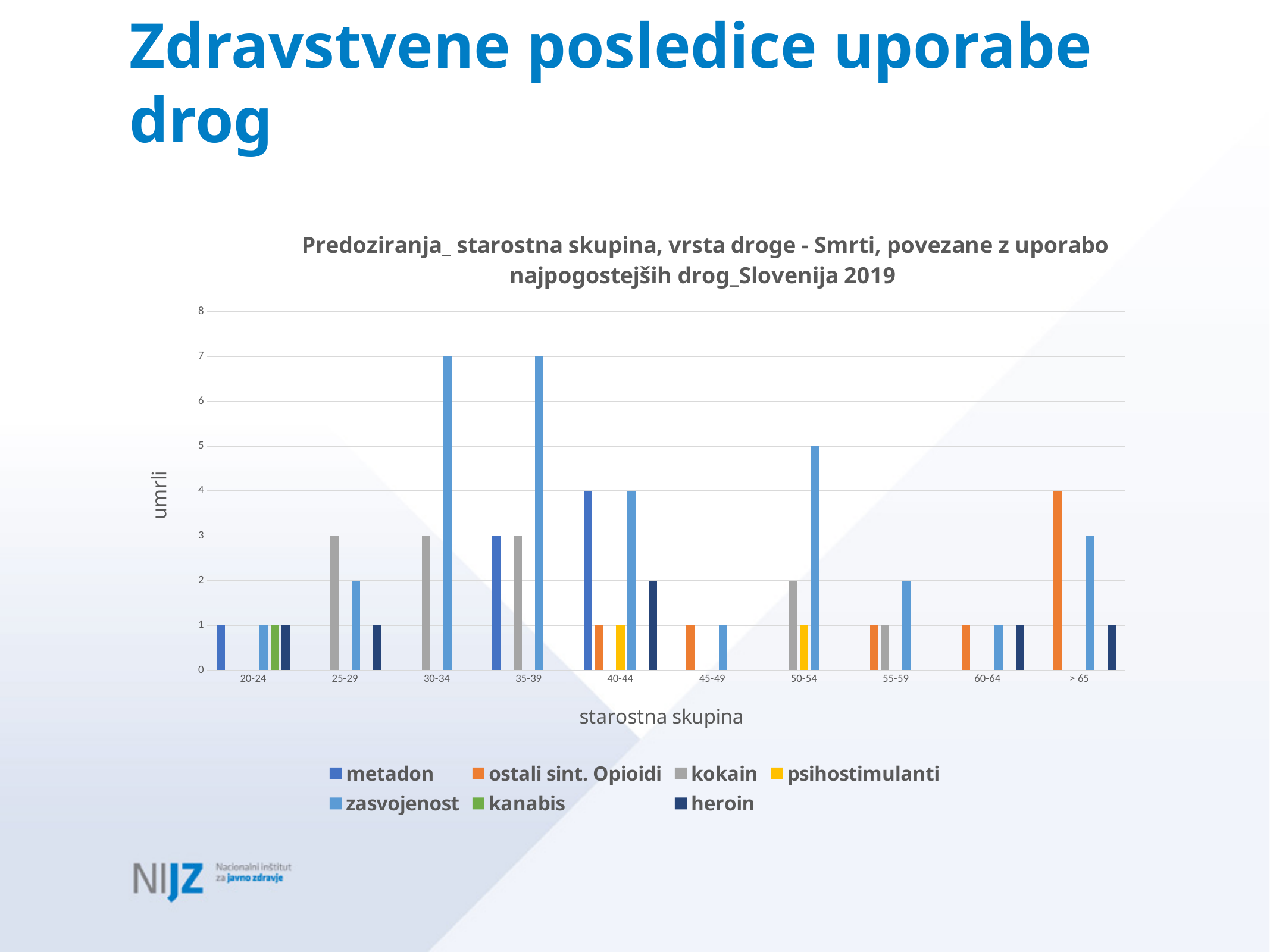
In which age group is the value for ostali sint. Opioidi highest? > 65 What is the difference between the zasvojenost values for the 30-34 and 50-54 age groups? 2 In which age group is the value for metadon highest? 40-44 Is the value for zasvojenost in the 35-39 age group greater or less than 6? greater What is the value for ostali sint. Opioidi in the > 65 age group? 4 What is the value for zasvojenost in the 30-34 age group? 7 What is the label of the y axis? umrli Which is larger: zasvojenost in the 50-54 age group or metadon in the 40-44 age group? zasvojenost in 50-54 How many age groups are shown on the x axis? 10 How many series does the legend list? 7 What is the value for metadon in the 40-44 age group? 4 What type of chart is shown on the slide? bar chart